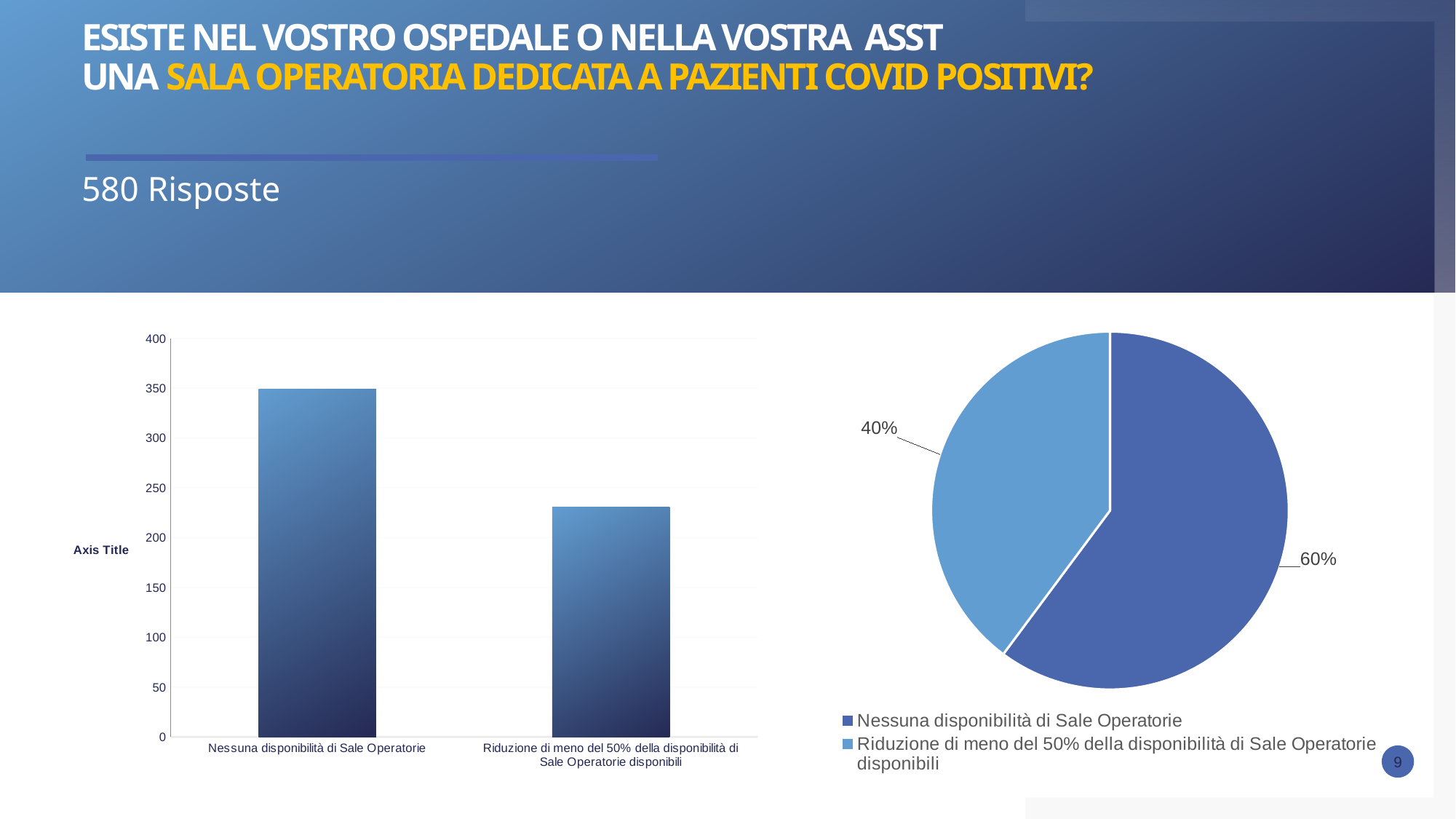
In the bar chart on the left, is the value for 'Riduzione di meno del 50% della disponibilità di Sale Operatorie disponibili' greater or less than 250? less In the bar chart on the left, is the value for 'Nessuna disponibilità di Sale Operatorie' greater or less than 300? greater In the pie chart, what is the difference in percentage points between the two slices? 20% In the pie chart, what share is shown for 'Nessuna disponibilità di Sale Operatorie'? 60% In the bar chart on the left, what is the highest value shown on the vertical axis? 400 What kind of chart is on the left side of the slide? bar chart In the bar chart on the left, which category has the highest bar? Nessuna disponibilità di Sale Operatorie In the pie chart, what share is shown for 'Riduzione di meno del 50% della disponibilità di Sale Operatorie disponibili'? 40% How many bars are in the bar chart on the left? 2 In the pie chart, which slice is the largest? Nessuna disponibilità di Sale Operatorie How many entries does the legend of the pie chart list? 2 What kind of chart is on the right side of the slide? pie chart